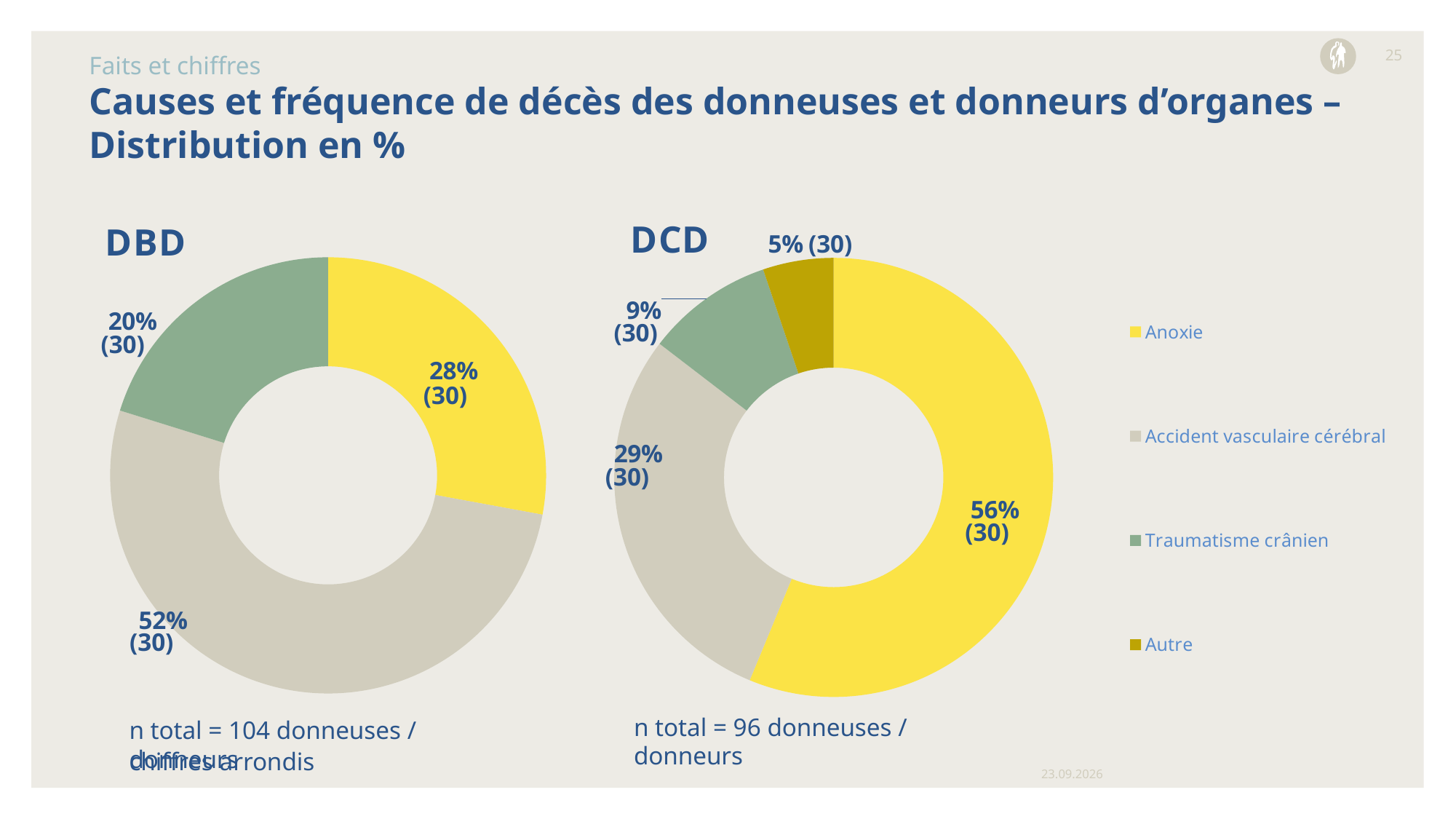
In the DCD chart, what share is labelled for Anoxie? 56% How many slices does the DCD chart have? 4 In the DBD chart, which cause of death has the largest share? Accident vasculaire cérébral In the DBD chart, what share is labelled for Anoxie? 28% In the DCD chart, what share is labelled for Traumatisme crânien? 9% Which chart shows a larger share for Anoxie, DBD or DCD? DCD In the DBD chart, what is the difference in percentage points between Accident vasculaire cérébral and Traumatisme crânien? 32 In the DCD chart, what is the difference in percentage points between Anoxie and Accident vasculaire cérébral? 27 In the DCD chart, which cause of death has the smallest share? Autre In the DCD chart, what share is labelled for Autre? 5% In the DBD chart, what share is labelled for Accident vasculaire cérébral? 52% What kind of chart is used for DBD and DCD on this slide? Pie chart (donut)